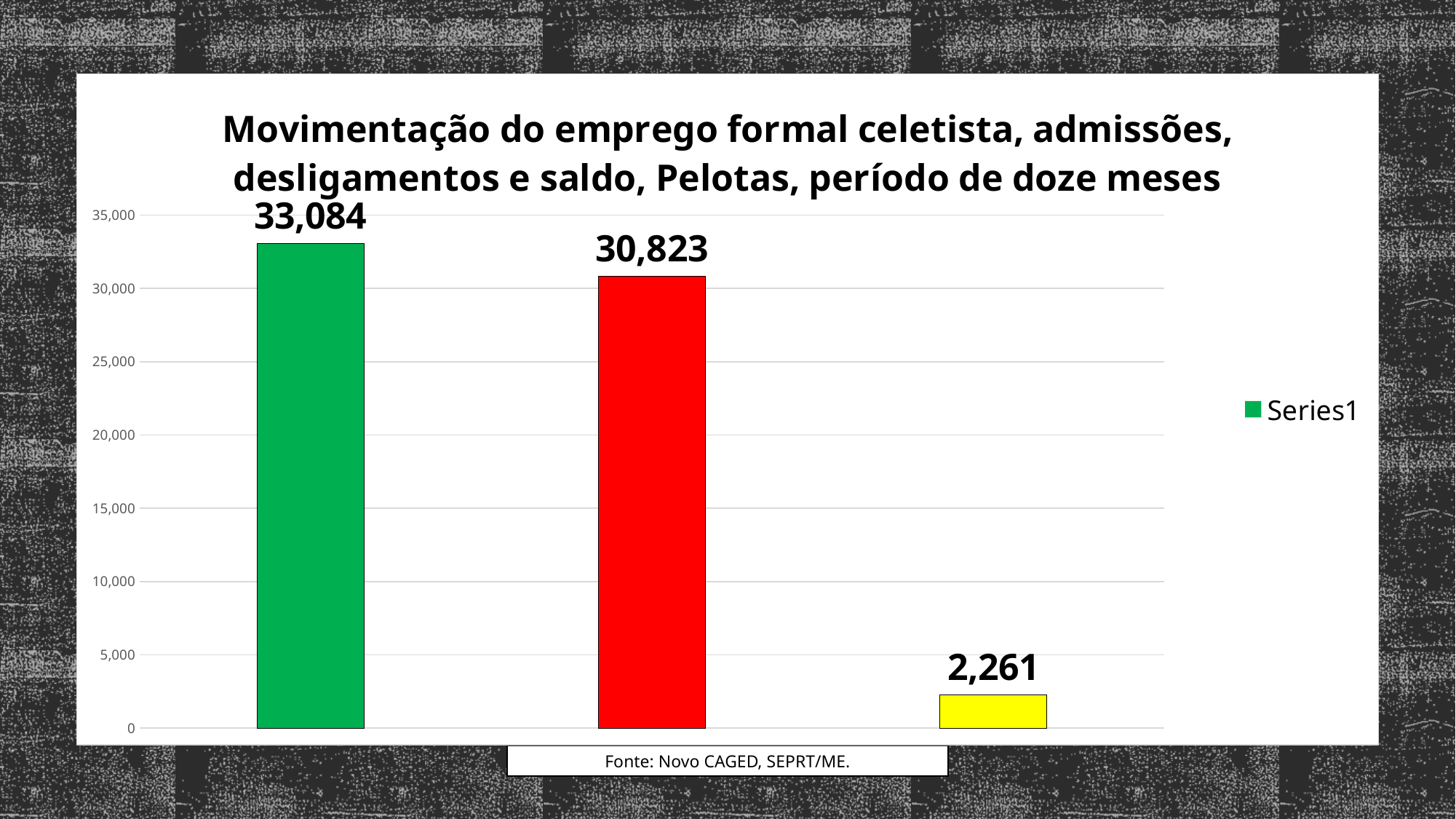
What is the difference between the value of the red bar and the value of the yellow bar? 28,562 Which bar has the highest value: the green, red or yellow bar? the green bar What is the value shown on the green bar (the first bar from the left)? 33,084 What is the value shown on the red bar (the middle bar)? 30,823 How many series does the legend list? 1 What is the difference between the value of the green bar and the value of the red bar? 2,261 What is the value shown on the yellow bar (the rightmost bar)? 2,261 What kind of chart is shown on the slide? bar chart Is the value of the yellow bar greater or less than 5,000? less Which bar has the lowest value: the green, red or yellow bar? the yellow bar How many bars are plotted in the chart? 3 Which is larger, the value of the green bar or the value of the red bar? the green bar